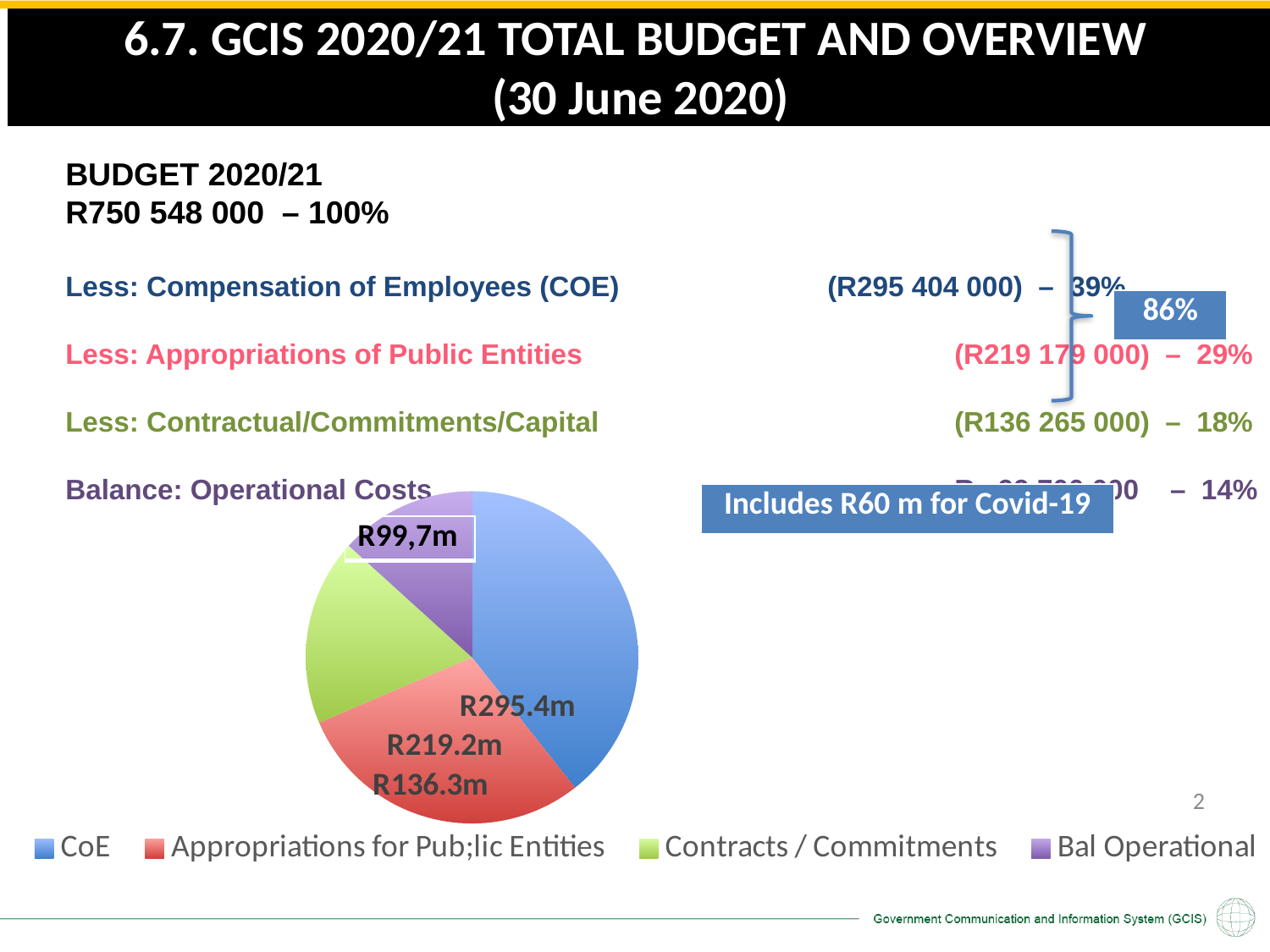
How many slices does the pie chart have? 4 What is the value shown for Appropriations for Pub;lic Entities in the pie chart? R219.2m Which category has the largest slice in the pie chart? CoE What type of chart is shown on the slide? pie chart What is the value shown for Contracts / Commitments in the pie chart? R136.3m Which is larger in the pie chart, CoE or Appropriations for Pub;lic Entities? CoE What is the difference between the CoE value and the Appropriations for Pub;lic Entities value in the pie chart? R76.2m Which category has the smallest slice in the pie chart? Bal Operational What is the value shown for Bal Operational in the pie chart? R99,7m How many entries does the pie chart's legend list? 4 What colour is the CoE slice in the pie chart? blue What is the value shown for CoE in the pie chart? R295.4m